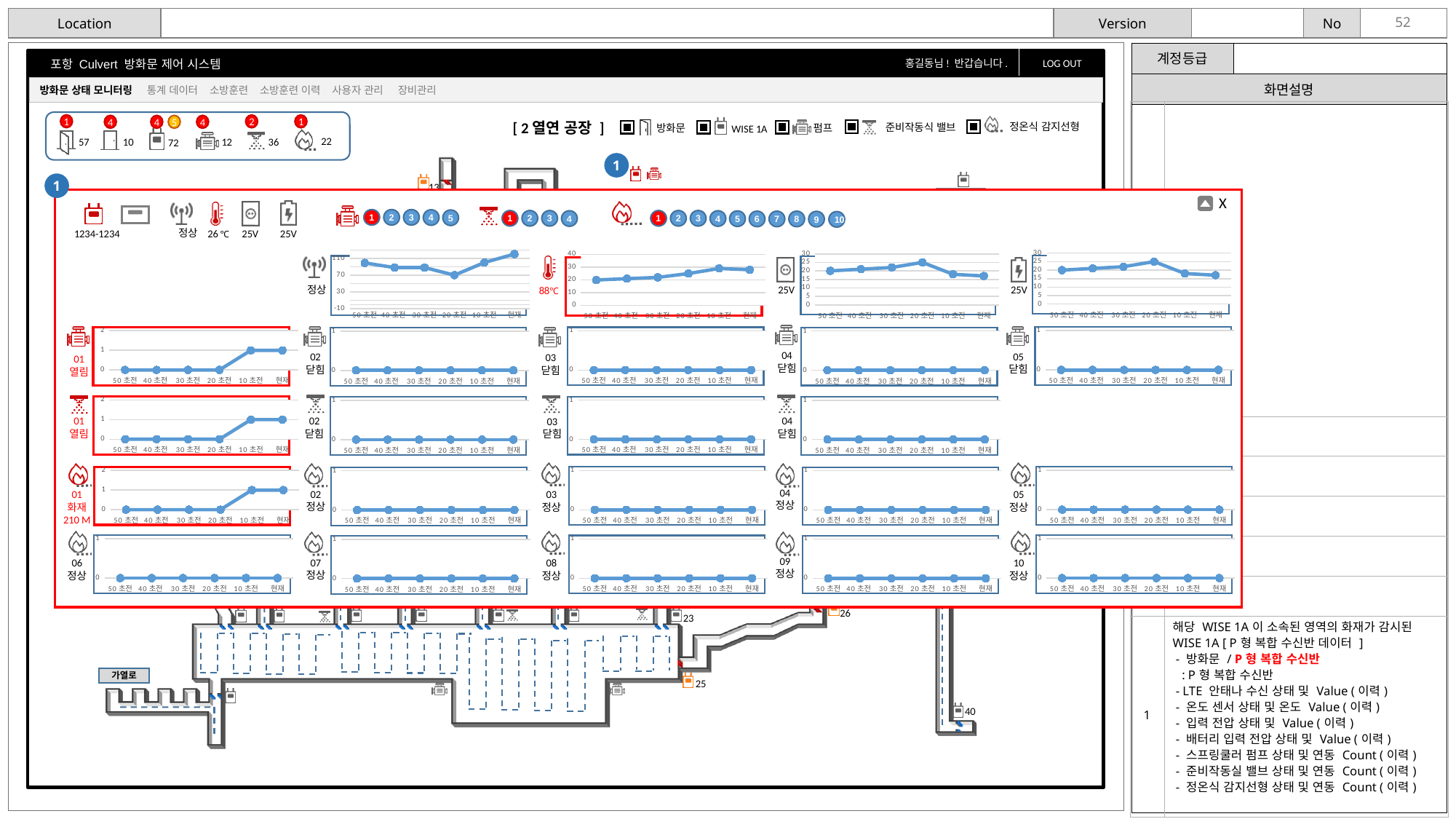
How many time points are plotted on the x axis of the pump 01 (열림) chart? 6 In the fire sensor 01 (화재 210 M) chart, what is the value at 10 초전? 1 In the pump 01 (열림) chart, what is the value at 50 초전? 0 In the input voltage chart (25V) in the top row, is the value at 50 초전 greater or less than 10? greater In the pump 01 (열림) chart, do the values rise or fall from 50 초전 to 현재? rise In the fire sensor 01 (화재 210 M) chart, what is the difference between the value at 현재 and the value at 20 초전? 1 In the pump 02 (닫힘) chart, what is the value at 현재? 0 In the temperature chart (88℃) in the top row, is the value at 현재 greater or less than 10? greater In the LTE antenna chart (정상) in the top row, is the value at 현재 greater or less than 70? greater In the pump 01 (열림) chart, what is the value at 현재? 1 What kind of chart is used for the pump 01 (열림) panel in the left column? line chart What is the last x-axis label on the sprinkler 01 (열림) chart? 현재